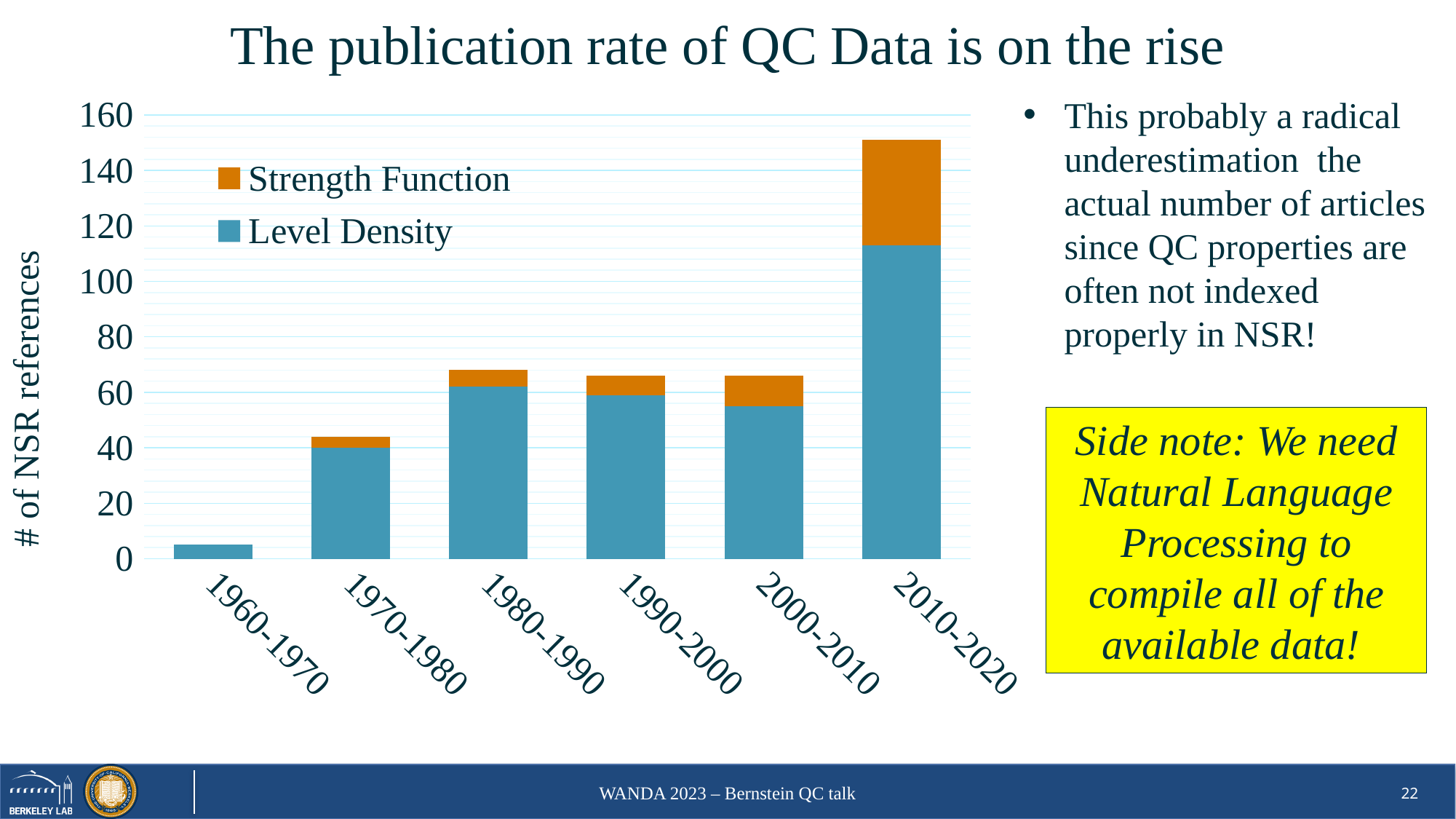
How many series does the chart's legend list? 2 Which decade has the highest total number of NSR references? 2010-2020 What is the label on the chart's vertical axis? # of NSR references Which has a larger total, 2010-2020 or 1980-1990? 2010-2020 Which decade has the lowest total number of NSR references? 1960-1970 Is the Level Density value for 1960-1970 greater or less than 20? less What kind of chart is shown on the slide? Stacked bar chart Is the total value for 2010-2020 greater or less than 140? greater Is the Level Density value for 2010-2020 greater or less than 100? greater What are the two series named in the chart's legend? Strength Function and Level Density How many decade categories are shown on the x axis of the chart? 6